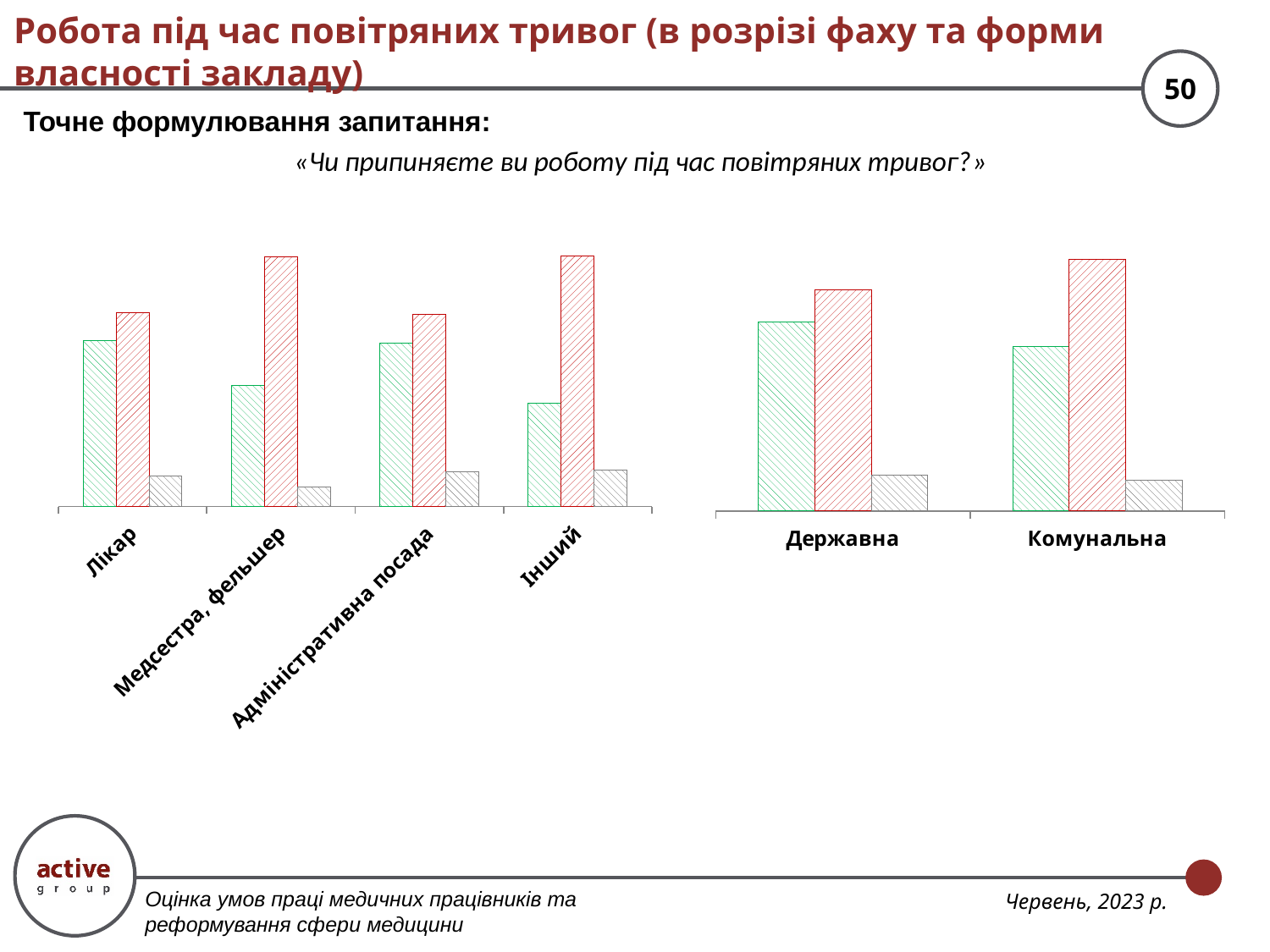
How many bars are plotted for each category in the right chart (by form of ownership)? 3 What kind of chart is the left chart (by profession)? bar chart In the right chart (by form of ownership), which bar is the shortest for the category Державна: the green, the red or the grey one? grey In the right chart (by form of ownership), which category has the taller red bar? Комунальна What kind of chart is the right chart (by form of ownership)? bar chart In the left chart (by profession), which category has the shortest green bar? Інший How many categories are shown on the x axis of the left chart (by profession)? 4 In the left chart (by profession), for the category Медсестра, фельшер, is the red bar or the green bar taller? red How many categories are shown on the x axis of the right chart (by form of ownership)? 2 What are the two category labels on the x axis of the right chart? Державна, Комунальна